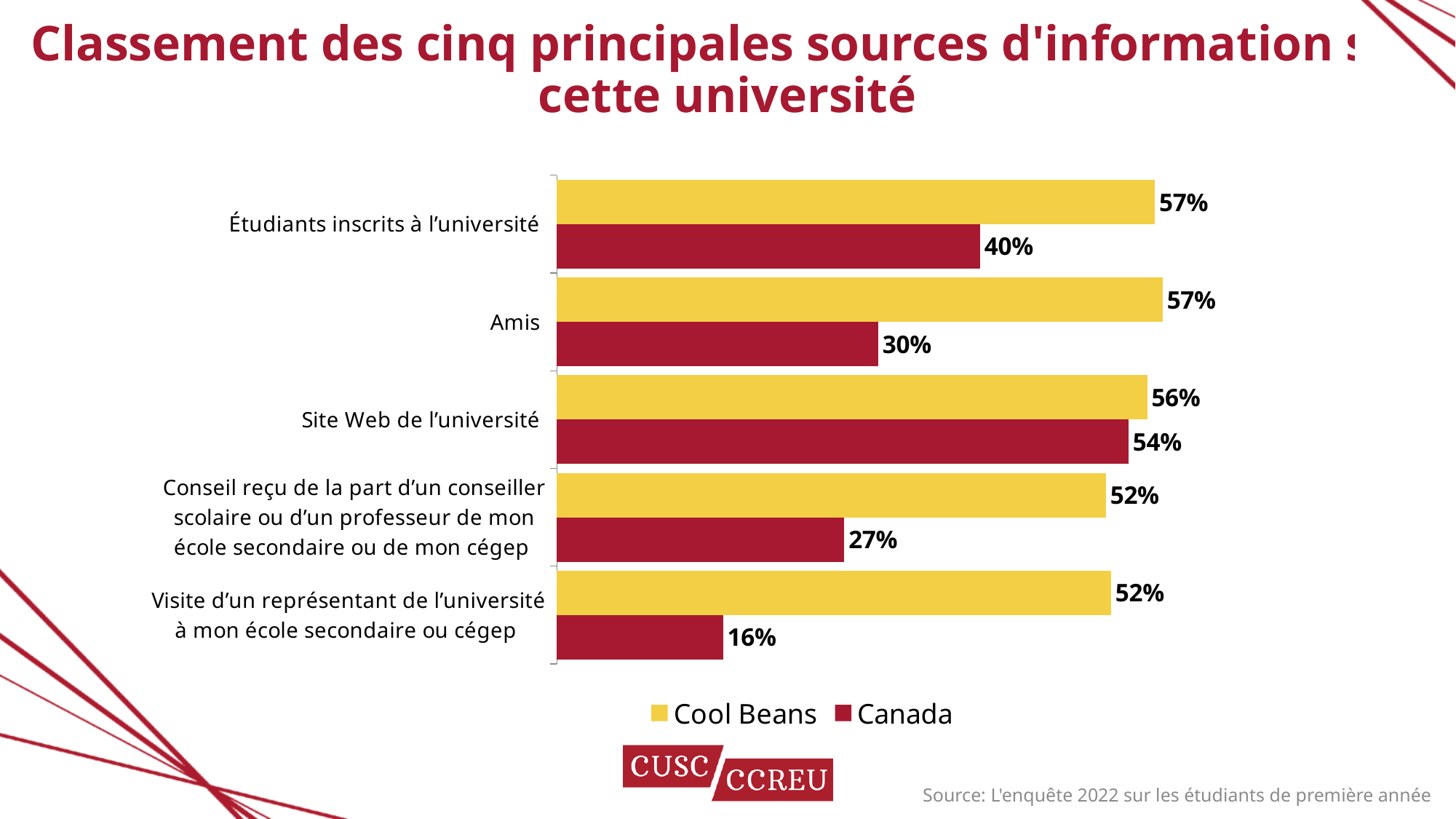
What kind of chart is shown on the slide? Bar chart What is the Canada value for Visite d'un représentant de l'université à mon école secondaire ou cégep? 16% Which is larger for Étudiants inscrits à l'université: the Cool Beans value or the Canada value? Cool Beans What is the difference between the Cool Beans and Canada values for Amis? 27% What is the Cool Beans value for Amis? 57% What is the Canada value for Site Web de l'université? 54% Which category has the lowest Canada value? Visite d'un représentant de l'université à mon école secondaire ou cégep What is the Cool Beans value for Conseil reçu de la part d'un conseiller scolaire ou d'un professeur de mon école secondaire ou de mon cégep? 52% What is the difference between the Canada values for Étudiants inscrits à l'université and Visite d'un représentant de l'université à mon école secondaire ou cégep? 24% How many series does the legend list? 2 Which category has the highest Canada value? Site Web de l'université How many categories are shown in the chart? 5